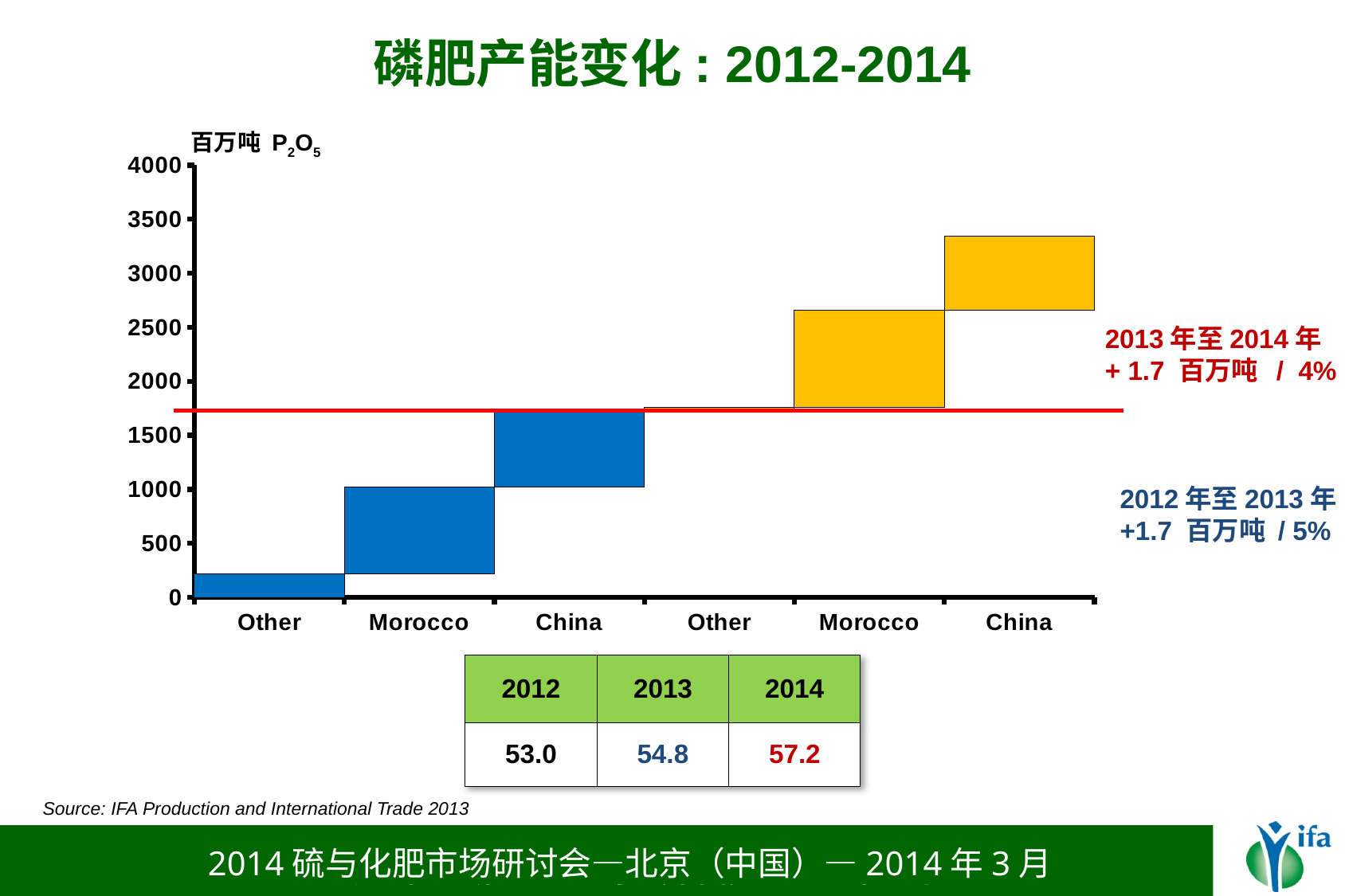
Is the top of the orange China bar greater or less than 3000? greater Is the top of the first (blue) Other bar greater or less than 500? less Which of the six bars represents the smallest change? Other (2013-2014, orange) What is the title of the slide's chart? 磷肥产能变化 : 2012-2014 What is the capacity value shown in the table for 2012? 53.0 According to the annotation, what was the change in phosphate capacity from 2013 to 2014? + 1.7 百万吨 / 4% What is the capacity value shown in the table for 2014? 57.2 Among the blue bars, which is larger: the Other bar or the Morocco bar? Morocco How many bars are plotted in the chart? 6 What unit is shown on the y axis of the chart? 百万吨 P2O5 According to the annotation, what was the percentage change in capacity from 2012 to 2013? 5% What kind of chart is shown on the slide? bar chart